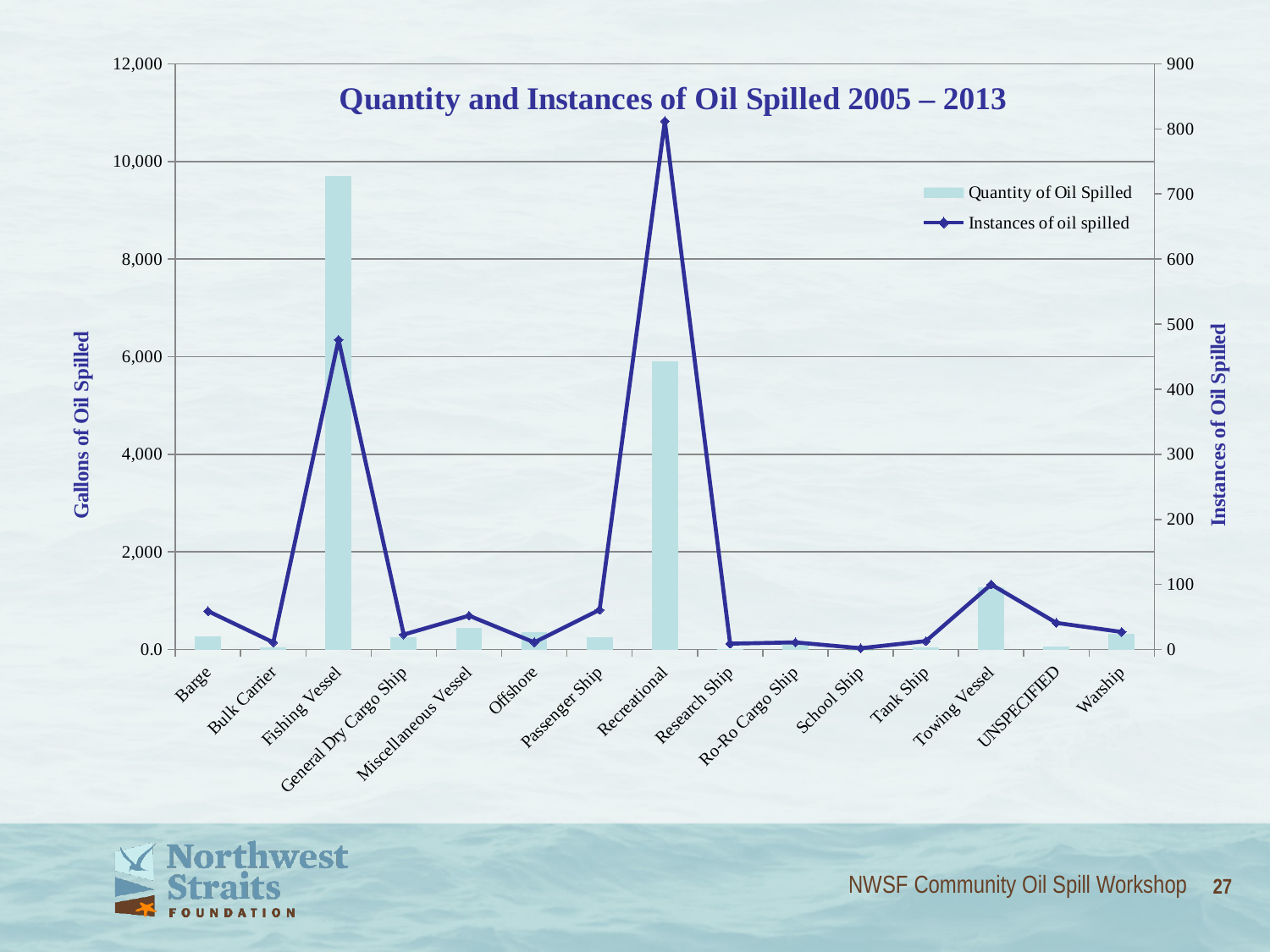
Is the Quantity of Oil Spilled for Fishing Vessel greater or less than 8,000 gallons? greater What is the title of the chart? Quantity and Instances of Oil Spilled 2005 – 2013 Which category has the highest number of Instances of oil spilled? Recreational Which has a larger Quantity of Oil Spilled, Fishing Vessel or Recreational? Fishing Vessel How many series does the chart legend list? 2 Which has more Instances of oil spilled, Towing Vessel or Barge? Towing Vessel How many vessel categories are shown on the x axis? 15 What is the label of the right-hand vertical axis? Instances of Oil Spilled Which category has the highest Quantity of Oil Spilled? Fishing Vessel Are the Instances of oil spilled for Fishing Vessel greater or less than 400? greater